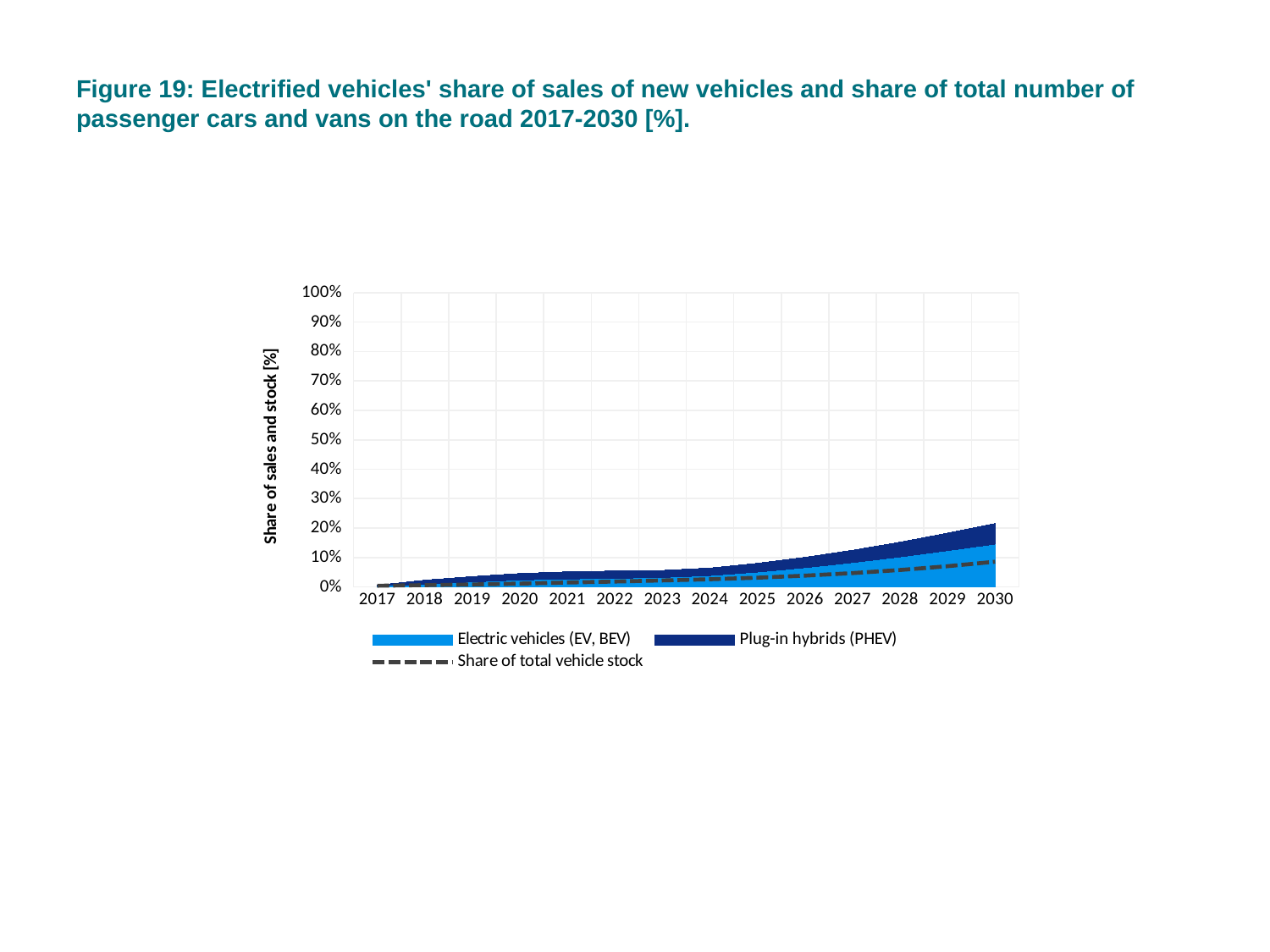
Is the combined share of electric vehicles and plug-in hybrids in 2025 greater or less than 10%? less Is the share of electric vehicles (EV, BEV) in 2030 greater or less than 10%? greater Is the combined share of electric vehicles and plug-in hybrids in 2020 greater or less than 10%? less Do the electrified vehicles' shares rise or fall from 2017 to 2030? Rise How many series does the legend list? 3 How many years are shown along the x axis? 14 What kind of chart is shown on the slide? Stacked area chart with a line Which series is drawn as a dashed line? Share of total vehicle stock Which year has the highest combined share of electric vehicles and plug-in hybrids? 2030 What is the label of the y axis? Share of sales and stock [%]